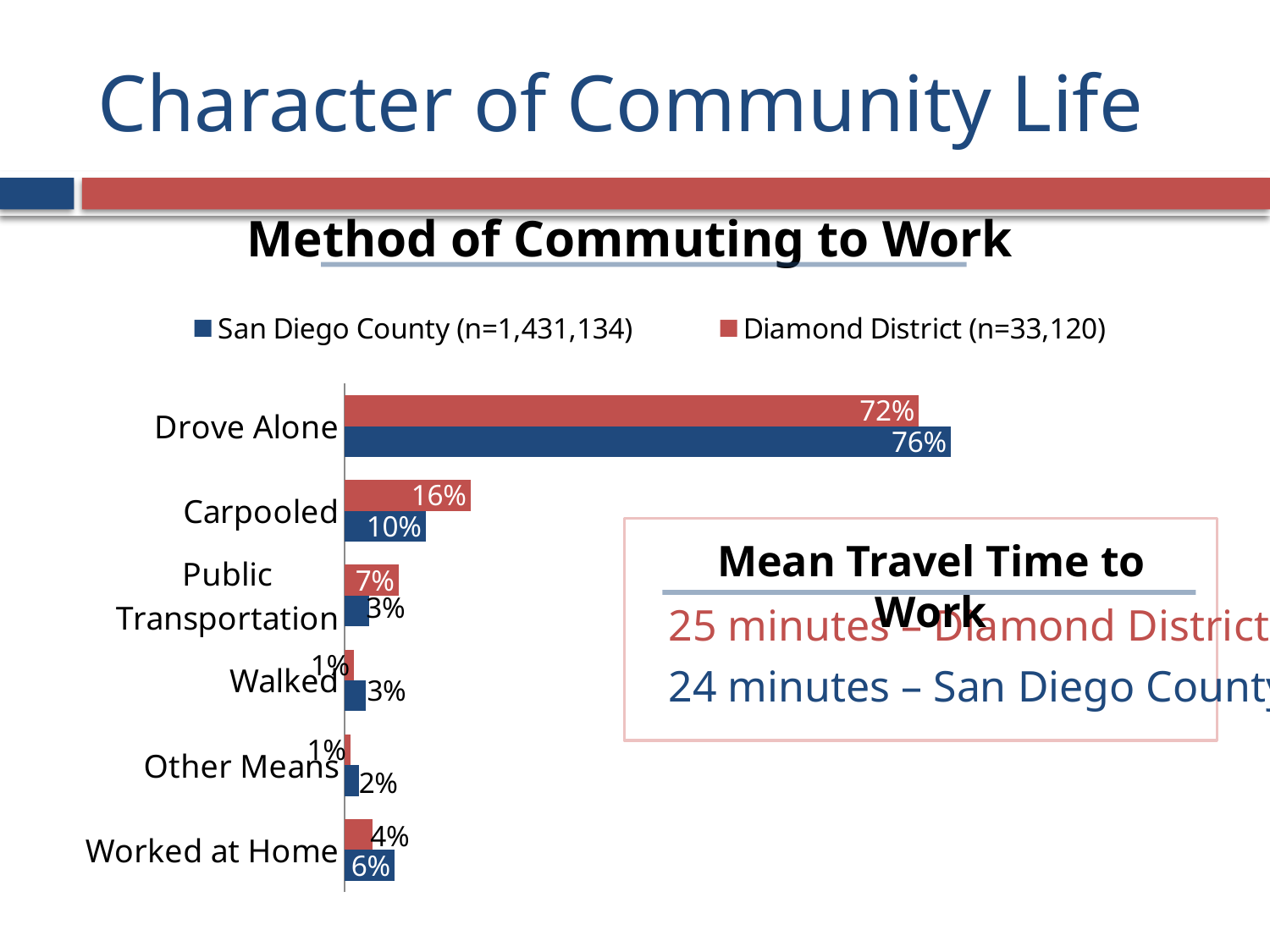
What percentage of San Diego County commuters drove alone? 76% Which commuting method has the highest value for Diamond District? Drove Alone What percentage of Diamond District commuters drove alone? 72% What type of chart is used to show Method of Commuting to Work? Bar chart How many commuting method categories are shown in the chart? 6 What is the Diamond District value for Carpooled? 16% How many series does the legend list? 2 What is the difference between the San Diego County and Diamond District values for Carpooled? 6% What is the difference between the San Diego County and Diamond District values for Drove Alone? 4% What is the San Diego County value for Worked at Home? 6% For Public Transportation, which is larger: the Diamond District value or the San Diego County value? Diamond District What is the San Diego County value for Public Transportation? 3%